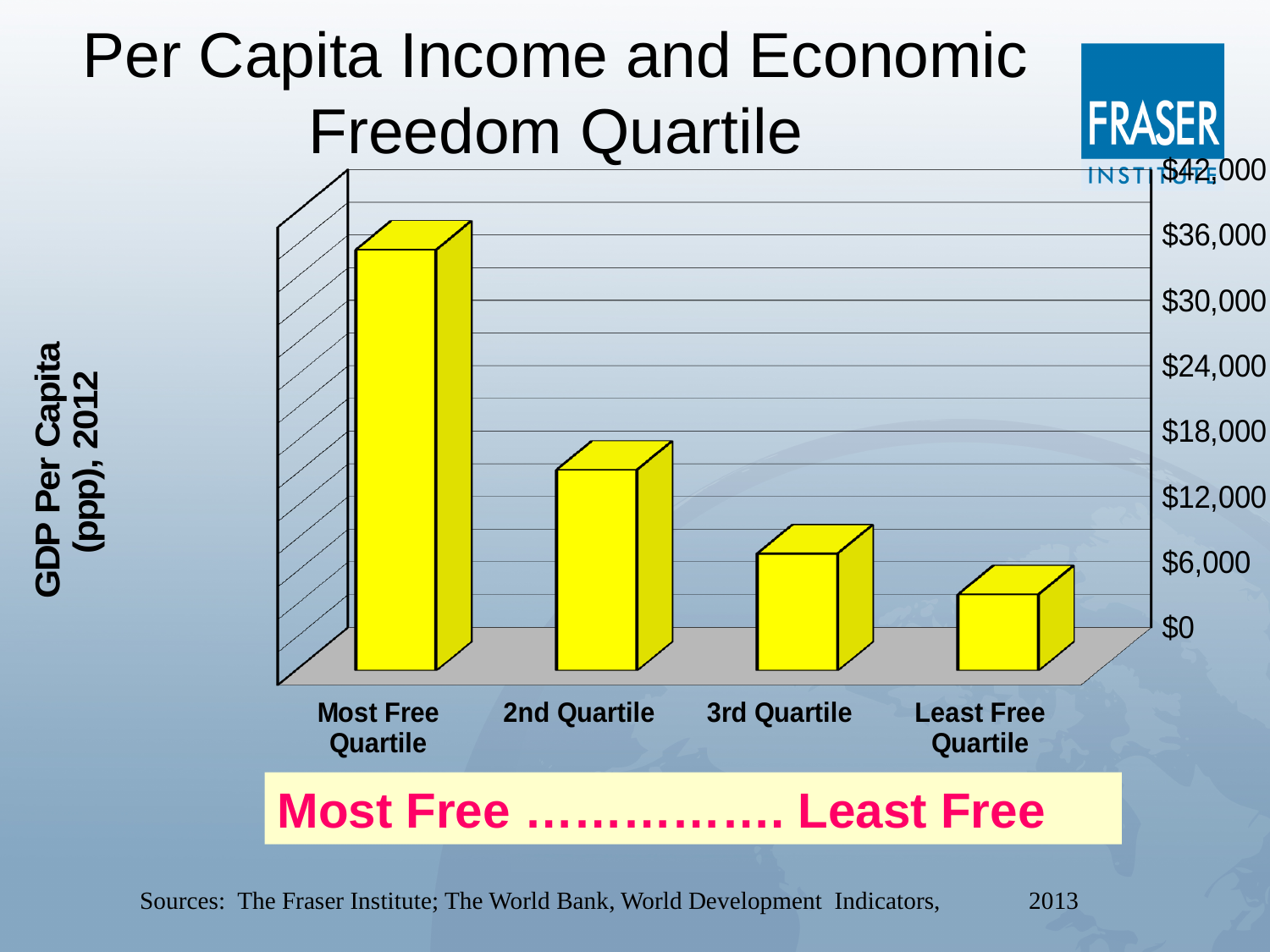
Which has a higher GDP per capita, the 3rd Quartile or the Least Free Quartile? 3rd Quartile What is the label on the vertical axis of the chart? GDP Per Capita (ppp), 2012 Do the values rise or fall moving from the Most Free Quartile to the Least Free Quartile? fall What kind of chart is shown on the slide? bar chart Is the value for the 3rd Quartile greater or less than $12,000? less Which quartile has the lowest GDP per capita? Least Free Quartile Which has a higher GDP per capita, the 2nd Quartile or the 3rd Quartile? 2nd Quartile How many quartile categories are plotted on the chart? 4 Is the value for the Least Free Quartile greater or less than $12,000? less Which quartile has the highest GDP per capita? Most Free Quartile Is the value for the Most Free Quartile greater or less than $24,000? greater